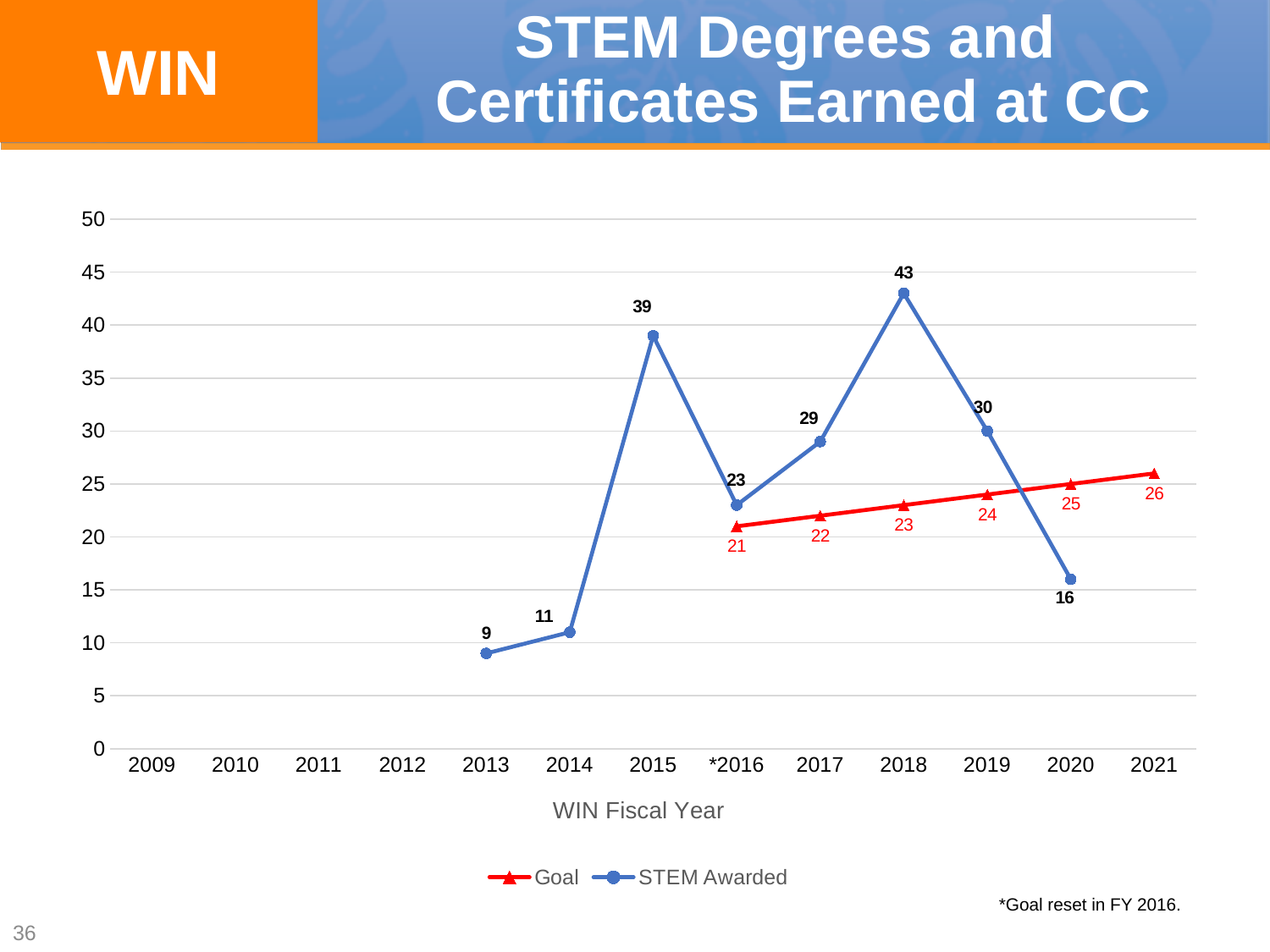
In which year was the STEM Awarded value lowest? 2013 How many series does the legend list? 2 Which is larger in 2020, the Goal value or the STEM Awarded value? Goal What was the STEM Awarded value in 2018? 43 Does the Goal series rise or fall from 2016 to 2021? rise In which year was the STEM Awarded value highest? 2018 What type of chart is shown on the slide? line chart How many years have a STEM Awarded data point plotted? 8 What is the difference between the STEM Awarded values in 2015 and 2014? 28 What was the Goal value for 2021? 26 What is the x-axis title of the chart? WIN Fiscal Year What is the difference between the STEM Awarded value and the Goal value in 2019? 6